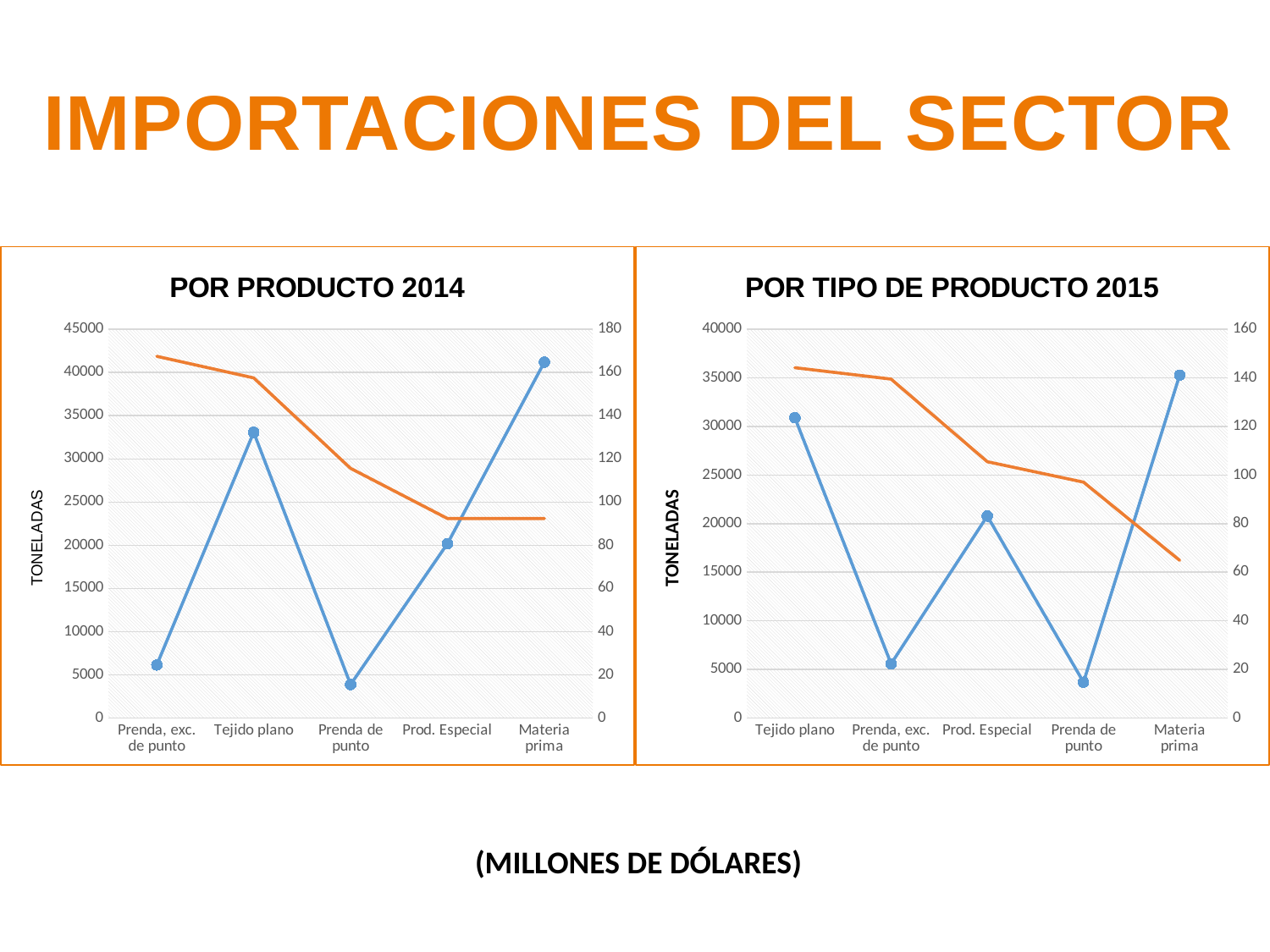
In the 'POR PRODUCTO 2014' chart, is the blue-line value for Tejido plano greater or less than 30000? greater In the 'POR PRODUCTO 2014' chart, which category has the highest value on the blue line? Materia prima What kind of chart is 'POR PRODUCTO 2014'? line chart In the 'POR PRODUCTO 2014' chart, which has the larger blue-line value, Tejido plano or Prod. Especial? Tejido plano In the 'POR TIPO DE PRODUCTO 2015' chart, is the blue-line value for Tejido plano greater or less than 25000? greater How many product categories are shown on the x axis of the 'POR TIPO DE PRODUCTO 2015' chart? 5 In the 'POR TIPO DE PRODUCTO 2015' chart, does the orange line rise or fall from Tejido plano to Materia prima? fall In the 'POR PRODUCTO 2014' chart, which category has the lowest value on the blue line? Prenda de punto In the 'POR TIPO DE PRODUCTO 2015' chart, is the blue-line value for Prenda de punto greater or less than 5000? less In the 'POR TIPO DE PRODUCTO 2015' chart, which category has the lowest value on the blue line? Prenda de punto In the 'POR TIPO DE PRODUCTO 2015' chart, which category has the highest value on the blue line? Materia prima